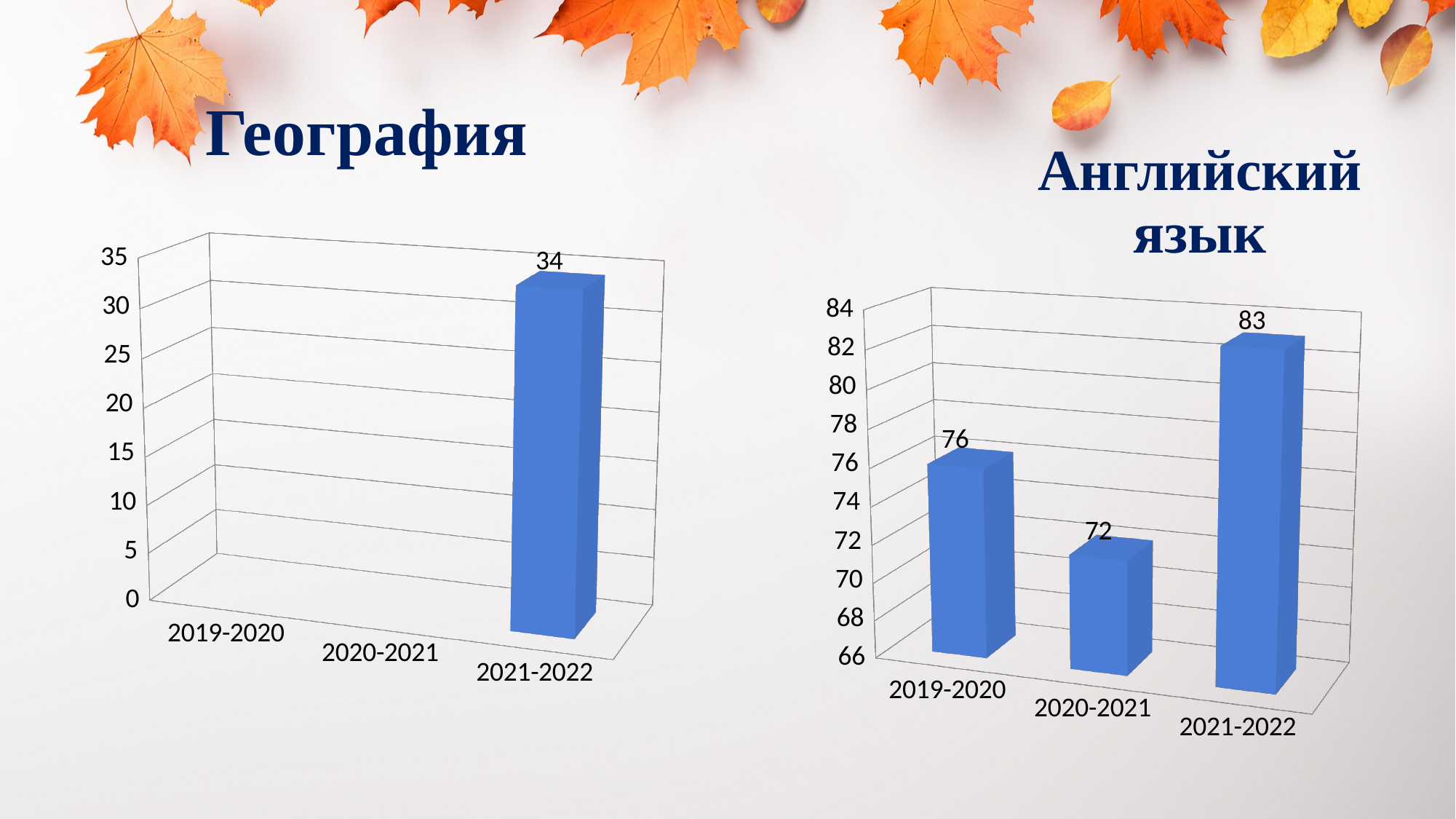
In the Английский язык chart, which year has the highest value? 2021-2022 In the География chart, is the value for 2021-2022 greater or less than 30? greater How many categories are shown on the x axis of the Английский язык chart? 3 In the Английский язык chart, what is the value for 2021-2022? 83 In the География chart, what is the value for 2021-2022? 34 In the Английский язык chart, what is the value for 2020-2021? 72 In the Английский язык chart, what is the value for 2019-2020? 76 What is the title of the chart on the right side of the slide? Английский язык What kind of chart is the География chart? bar chart In the Английский язык chart, which year has the lowest value? 2020-2021 In the Английский язык chart, what is the difference between the values for 2021-2022 and 2020-2021? 11 In the Английский язык chart, which is larger, the value for 2019-2020 or the value for 2020-2021? 2019-2020